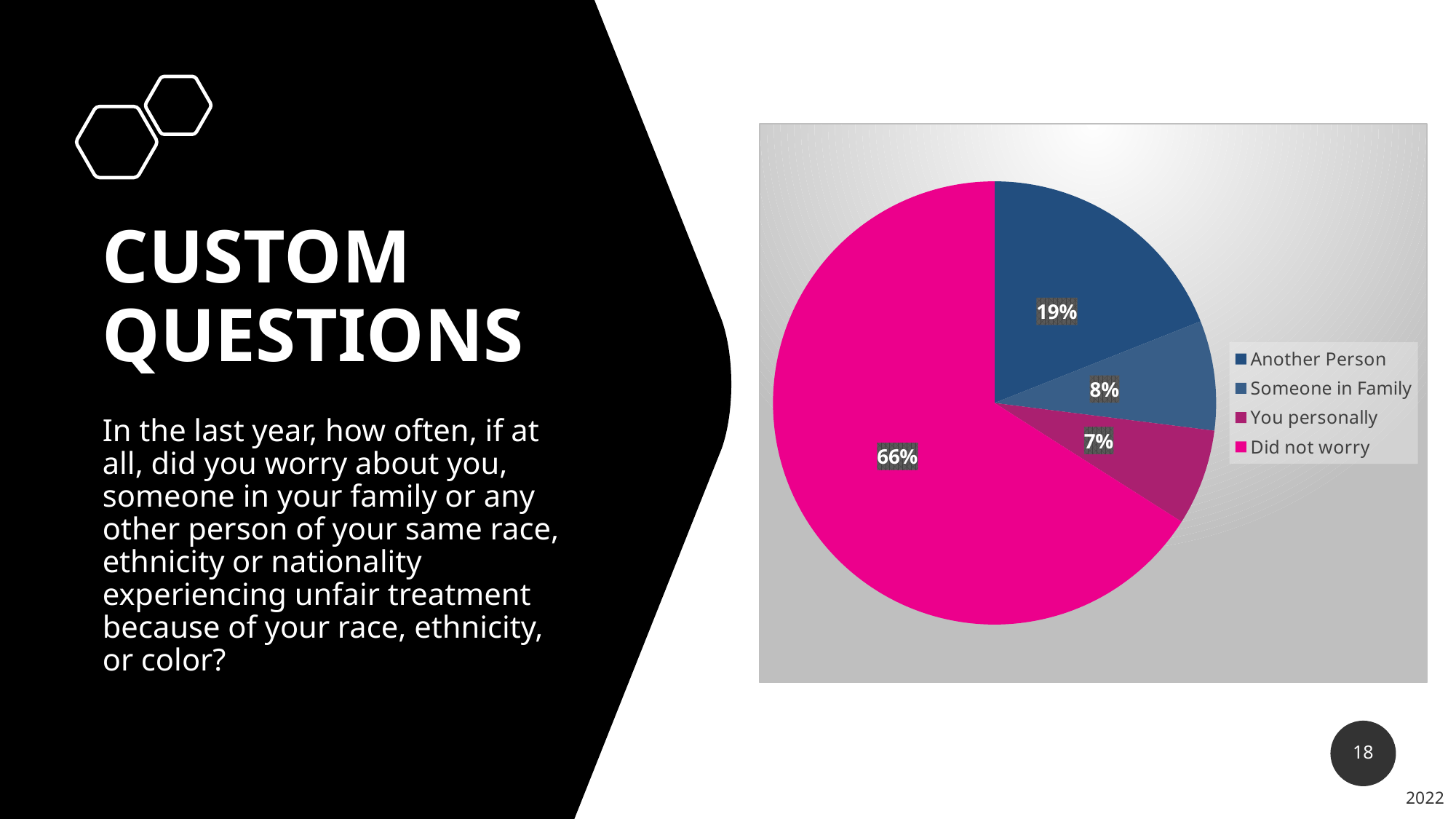
Which category has the smallest slice of the pie? You personally What percentage of the pie is labelled 'Did not worry'? 66% What colour is the 'Did not worry' slice? Pink Which category has the largest slice of the pie? Did not worry Which is larger, the slice for 'Another Person' or the slice for 'Someone in Family'? Another Person What percentage of the pie is labelled 'Someone in Family'? 8% What percentage of the pie is labelled 'You personally'? 7% What kind of chart is shown on the slide? Pie chart What is the difference in percentage points between 'Did not worry' and 'Another Person'? 47 How many slices does the pie chart have? 4 How many entries does the legend list? 4 What percentage of the pie is labelled 'Another Person'? 19%